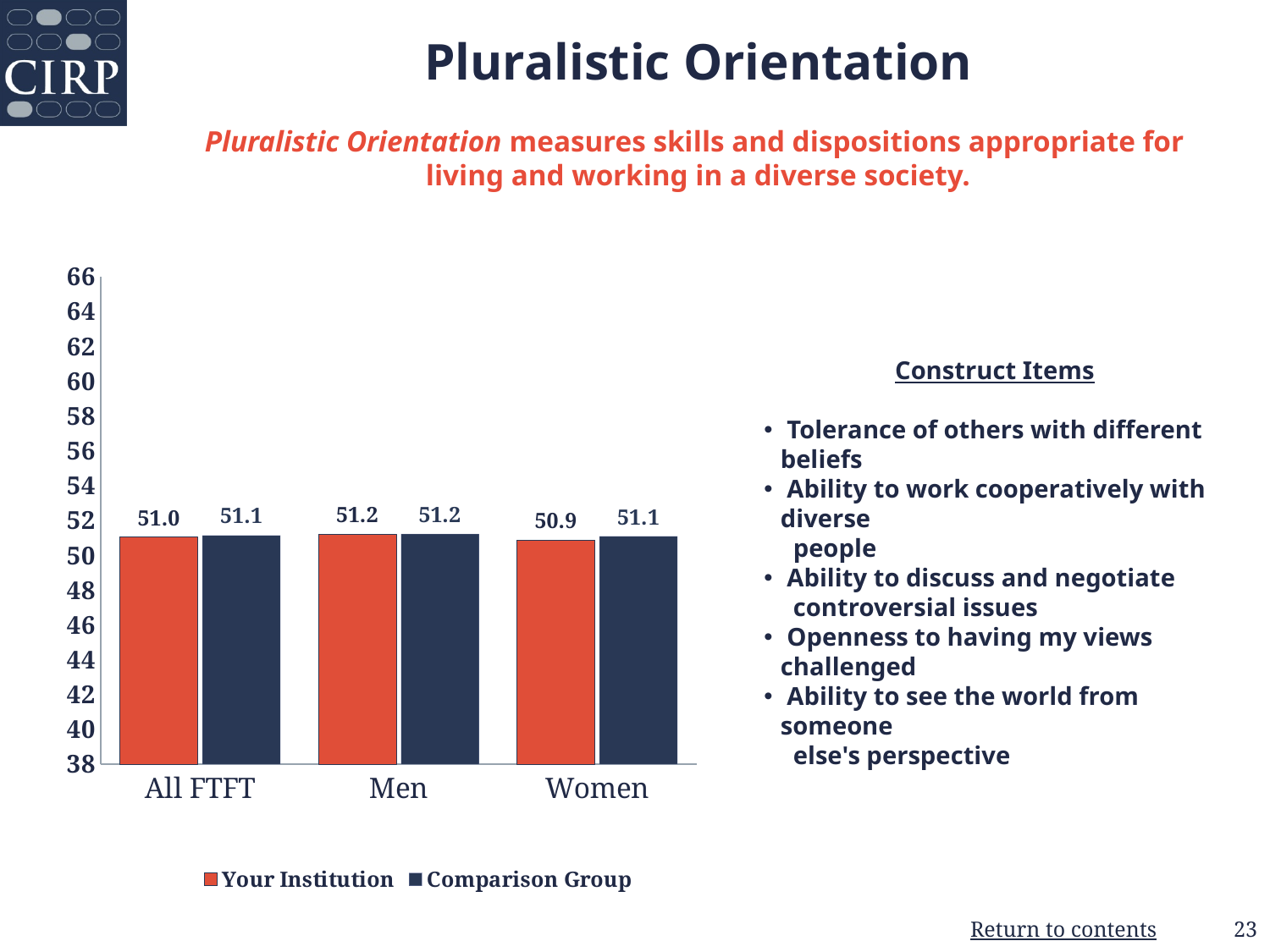
Which category has the highest value for Your Institution? Men What is the value for Comparison Group in the Women category? 51.1 What kind of chart is shown on the slide? Bar chart How many series does the legend list? 2 What is the difference between the Comparison Group and Your Institution values in the Women category? 0.2 How many categories are shown on the x axis? 3 What is the value for Your Institution in the Men category? 51.2 What is the value for Your Institution in the All FTFT category? 51.0 Which series is shown in dark blue in the legend? Comparison Group What is the difference between the Your Institution values for Men and Women? 0.3 Which category has the lowest value for Your Institution? Women What is the value for Comparison Group in the All FTFT category? 51.1